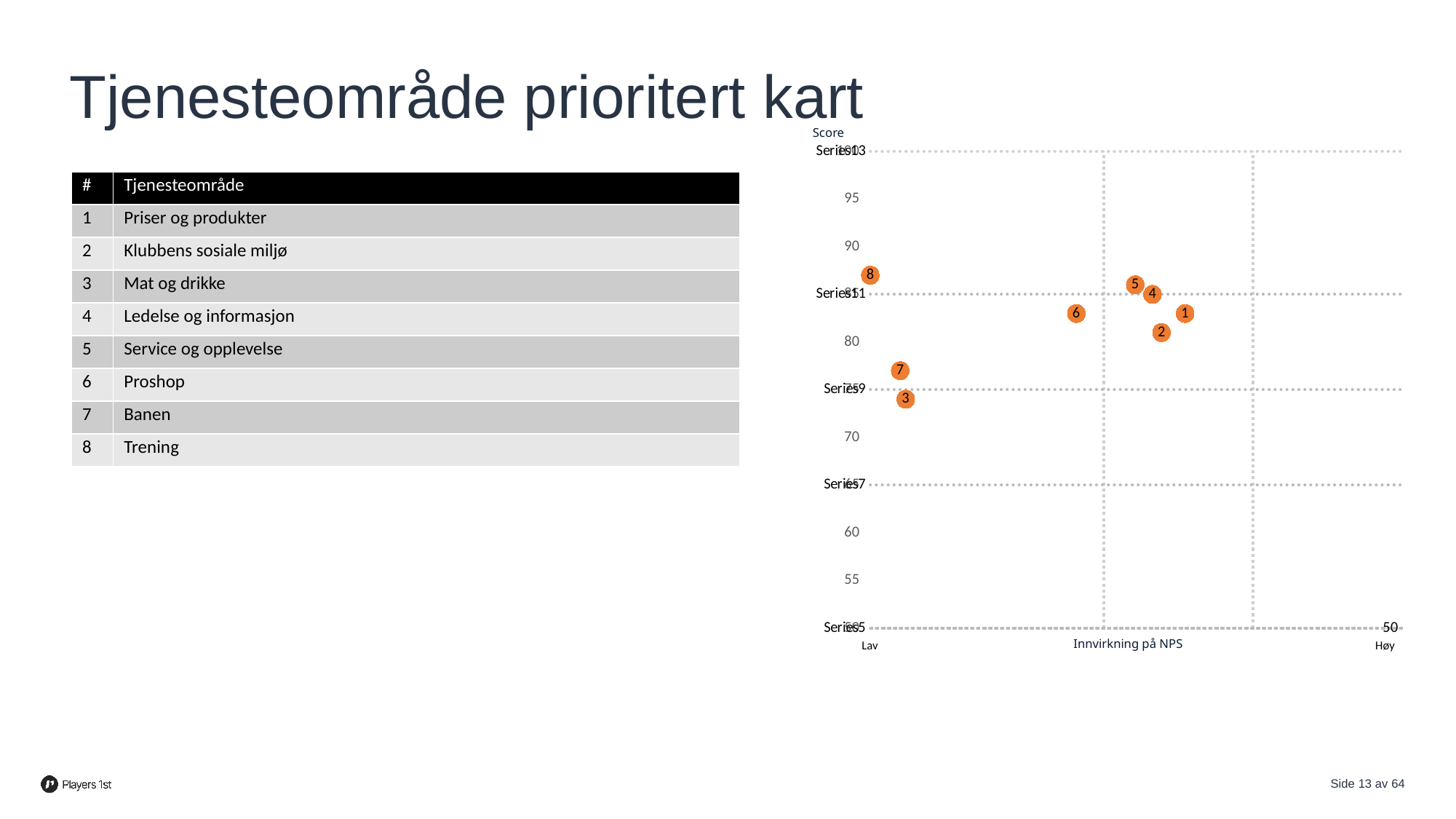
Which numbered point is furthest to the left (lowest Innvirkning på NPS)? 8 Is the Score for point 2 greater or less than 85? less Which has the higher Score, point 7 or point 3? point 7 Which numbered point has the lowest Score on the chart? 3 Which has the higher Score, point 1 or point 2? point 1 What kind of chart is shown on the slide? scatter chart Is the Score for point 6 greater or less than 80? greater Is the Score for point 8 greater or less than 85? greater What is the label of the horizontal axis of the chart? Innvirkning på NPS Which numbered point is furthest to the right (highest Innvirkning på NPS)? 1 How many numbered points are plotted on the chart? 8